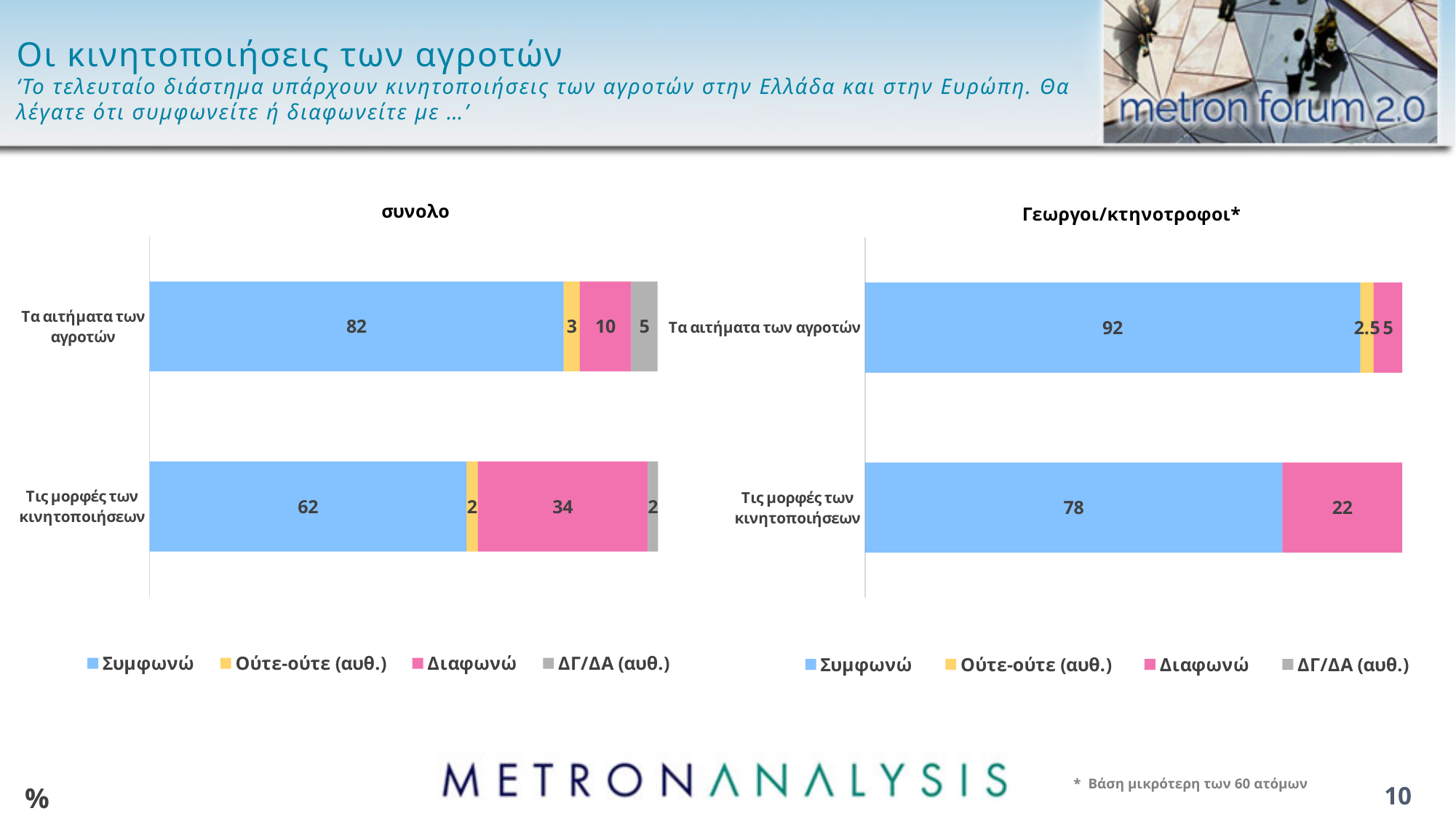
How many series does the legend of the 'συνολο' chart list? 4 In the 'συνολο' chart, what is the value of Διαφωνώ for 'Τις μορφές των κινητοποιήσεων'? 34 In the 'συνολο' chart, what is the value of ΔΓ/ΔΑ (αυθ.) for 'Τα αιτήματα των αγροτών'? 5 In the 'συνολο' chart, what is the total of the stacked bar for 'Τις μορφές των κινητοποιήσεων'? 100 In the 'συνολο' chart, what is the value of Συμφωνώ for 'Τα αιτήματα των αγροτών'? 82 What kind of chart is the 'συνολο' chart? Stacked bar chart In the 'Γεωργοι/κτηνοτροφοι*' chart, what is the value of Διαφωνώ for 'Τις μορφές των κινητοποιήσεων'? 22 In the 'συνολο' chart, what is the difference between the Συμφωνώ values for 'Τα αιτήματα των αγροτών' and 'Τις μορφές των κινητοποιήσεων'? 20 In the 'Γεωργοι/κτηνοτροφοι*' chart, what is the value of Συμφωνώ for 'Τα αιτήματα των αγροτών'? 92 In the 'Γεωργοι/κτηνοτροφοι*' chart, which category has the higher Συμφωνώ value? Τα αιτήματα των αγροτών In the 'συνολο' chart, which category has the highest Διαφωνώ value? Τις μορφές των κινητοποιήσεων How many categories are shown in the 'Γεωργοι/κτηνοτροφοι*' chart? 2